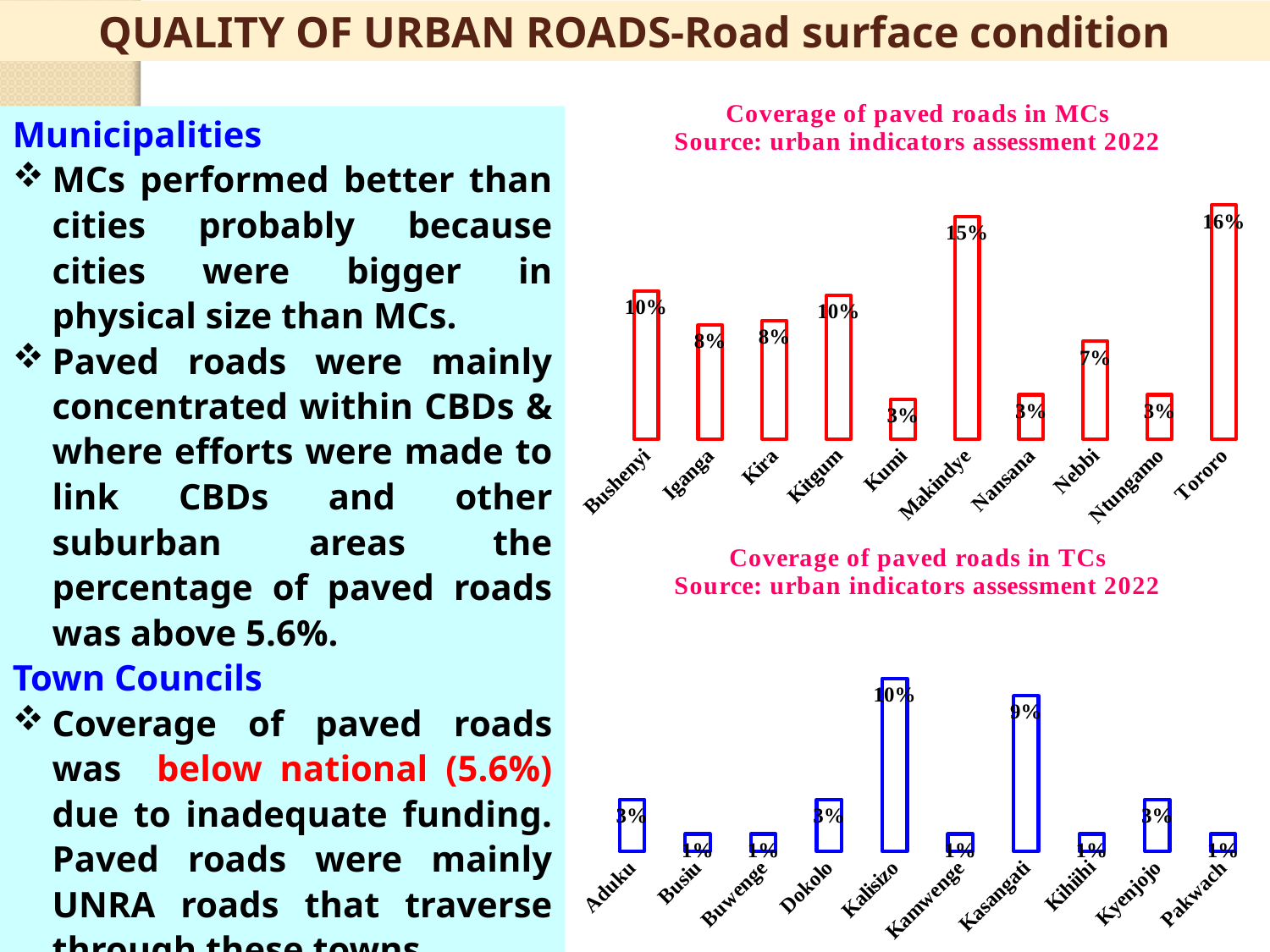
In the 'Coverage of paved roads in MCs' chart, what is the value for Makindye? 15% In the 'Coverage of paved roads in MCs' chart, what is the difference between Tororo and Bushenyi? 6% In the 'Coverage of paved roads in TCs' chart, which town council has the highest coverage of paved roads? Kalisizo What source is cited under the title of the 'Coverage of paved roads in MCs' chart? Urban indicators assessment 2022 In the 'Coverage of paved roads in TCs' chart, what is the difference between Kalisizo and Dokolo? 7% In the 'Coverage of paved roads in MCs' chart, which municipality has the highest coverage of paved roads? Tororo What type of chart is the 'Coverage of paved roads in TCs' chart? Bar chart In the 'Coverage of paved roads in MCs' chart, what is the value for Nebbi? 7% In the 'Coverage of paved roads in MCs' chart, which is larger, Kitgum or Iganga? Kitgum In the 'Coverage of paved roads in TCs' chart, which is larger, Aduku or Busiu? Aduku How many municipalities are shown in the 'Coverage of paved roads in MCs' chart? 10 In the 'Coverage of paved roads in TCs' chart, what is the value for Kasangati? 9%